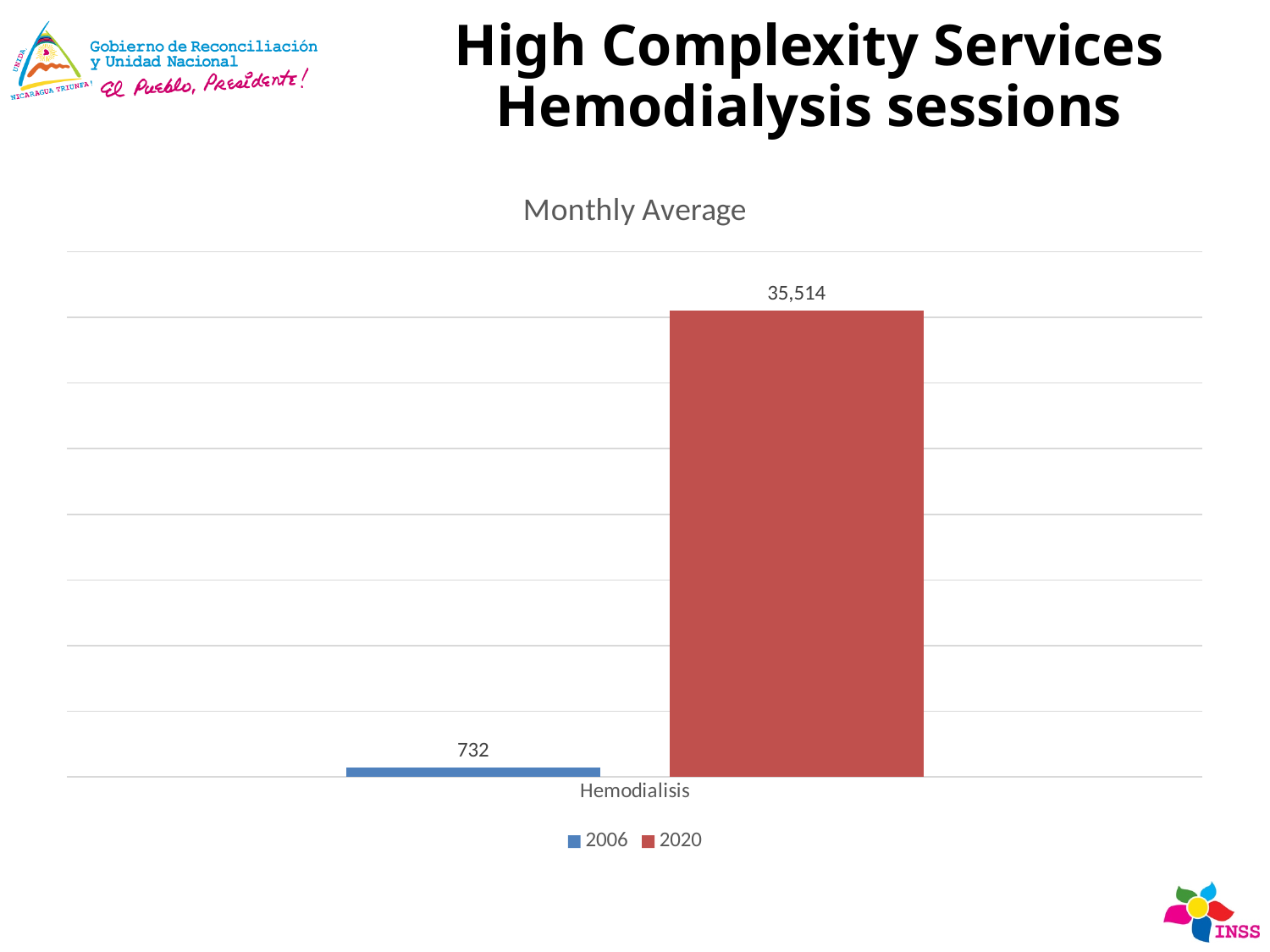
How many categories are shown on the x axis? 1 What is the title of the chart? Monthly Average What kind of chart is shown on the slide? bar chart Is the 2006 value larger or smaller than the 2020 value? smaller What is the category label on the x axis? Hemodialisis What is the difference between the 2020 and 2006 monthly averages of hemodialysis sessions? 34,782 Which year has the higher monthly average of hemodialysis sessions? 2020 What is the monthly average number of hemodialysis sessions for 2020? 35,514 What colour is the bar for 2020? red Which year has the lower monthly average of hemodialysis sessions? 2006 What is the monthly average number of hemodialysis sessions for 2006? 732 How many series does the legend list? 2